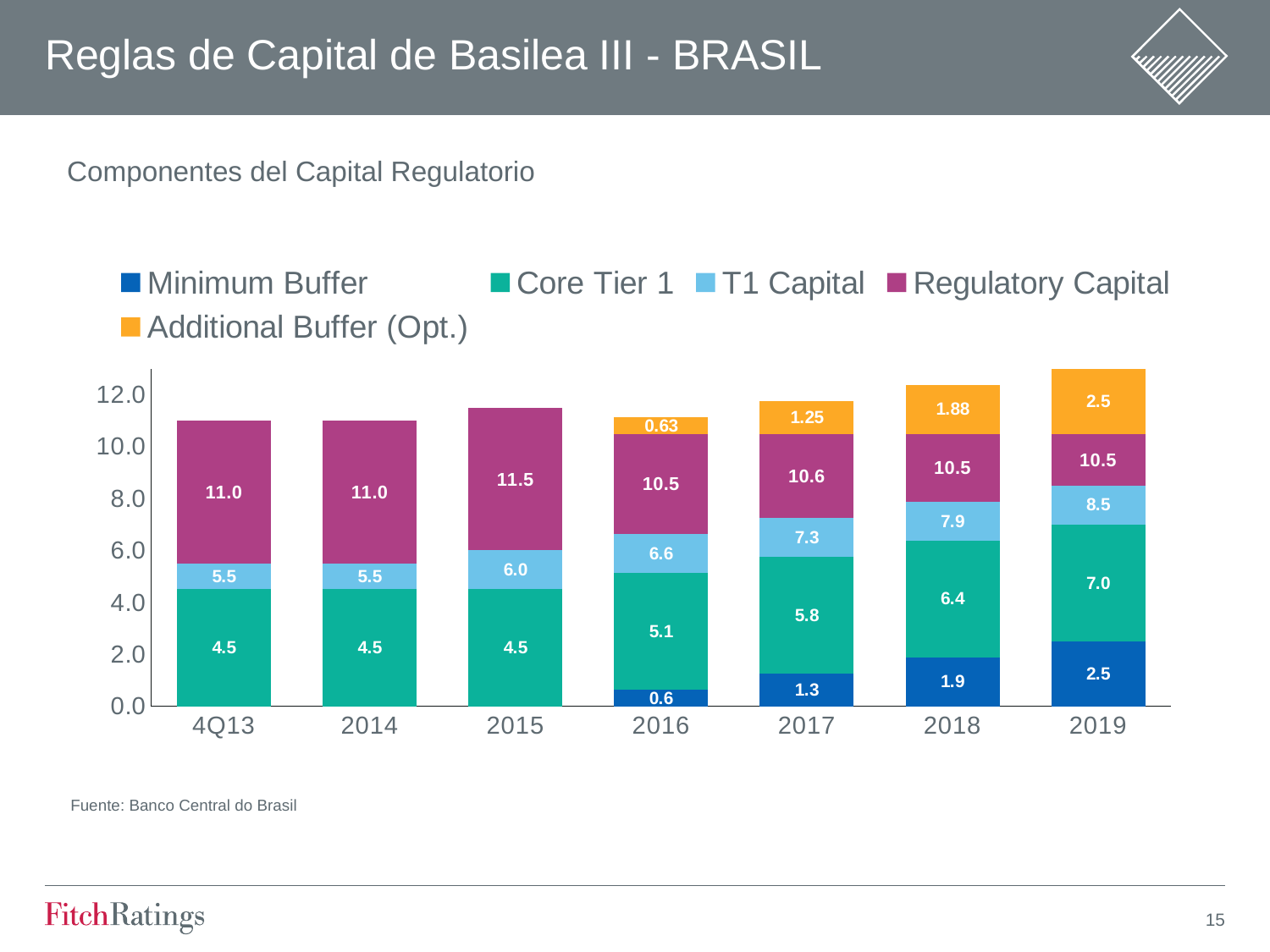
What is the Minimum Buffer value labelled for 2016? 0.6 Which year has the highest labelled Core Tier 1 value? 2019 How many series does the legend list? 5 What is the difference between the Core Tier 1 labels for 2019 and 4Q13? 2.5 Is the Additional Buffer (Opt.) label larger for 2018 or for 2017? 2018 What kind of chart is shown on the slide? Stacked bar chart Which year has the lowest labelled Minimum Buffer value? 2016 What is the Additional Buffer (Opt.) value labelled for 2017? 1.25 What is the Regulatory Capital value labelled for 2015? 11.5 What is the Core Tier 1 value labelled for 2019? 7.0 What is the T1 Capital value labelled for 2018? 7.9 How many periods are shown on the x axis? 7